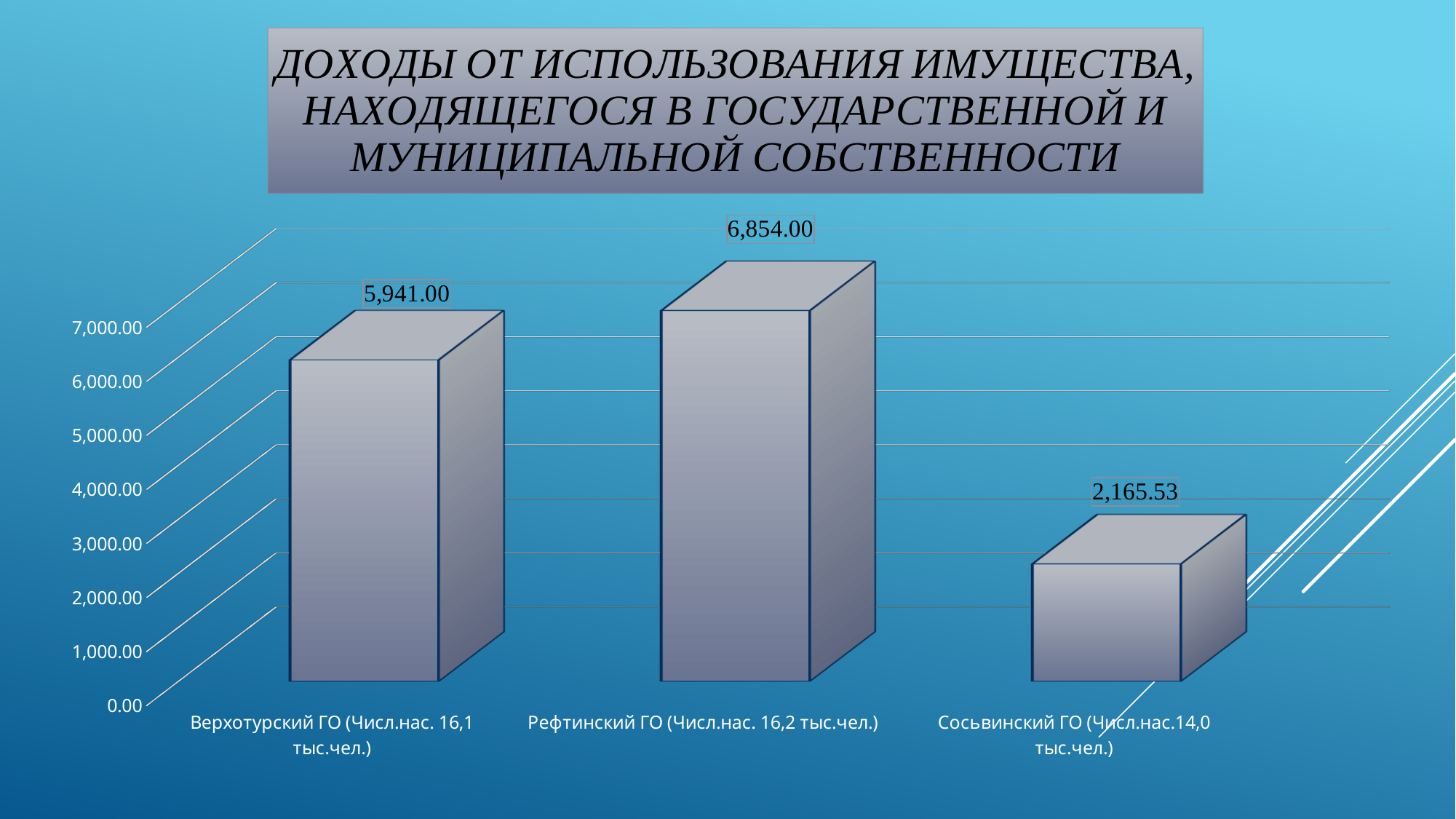
Which category has the lowest value? Сосьвинский ГО What is the population figure given in the axis label for Сосьвинский ГО? 14,0 тыс.чел. Which is larger, the value for Верхотурский ГО or the value for Сосьвинский ГО? Верхотурский ГО What is the value for Рефтинский ГО? 6,854.00 What is the difference between the values for Рефтинский ГО and Верхотурский ГО? 913.00 How many categories are shown in the chart? 3 What is the value for Верхотурский ГО? 5,941.00 What is the value for Сосьвинский ГО? 2,165.53 Is the value for Сосьвинский ГО greater or less than 3,000.00? less What is the difference between the values for Верхотурский ГО and Сосьвинский ГО? 3,775.47 What kind of chart is shown on the slide? bar chart Which category has the highest value? Рефтинский ГО